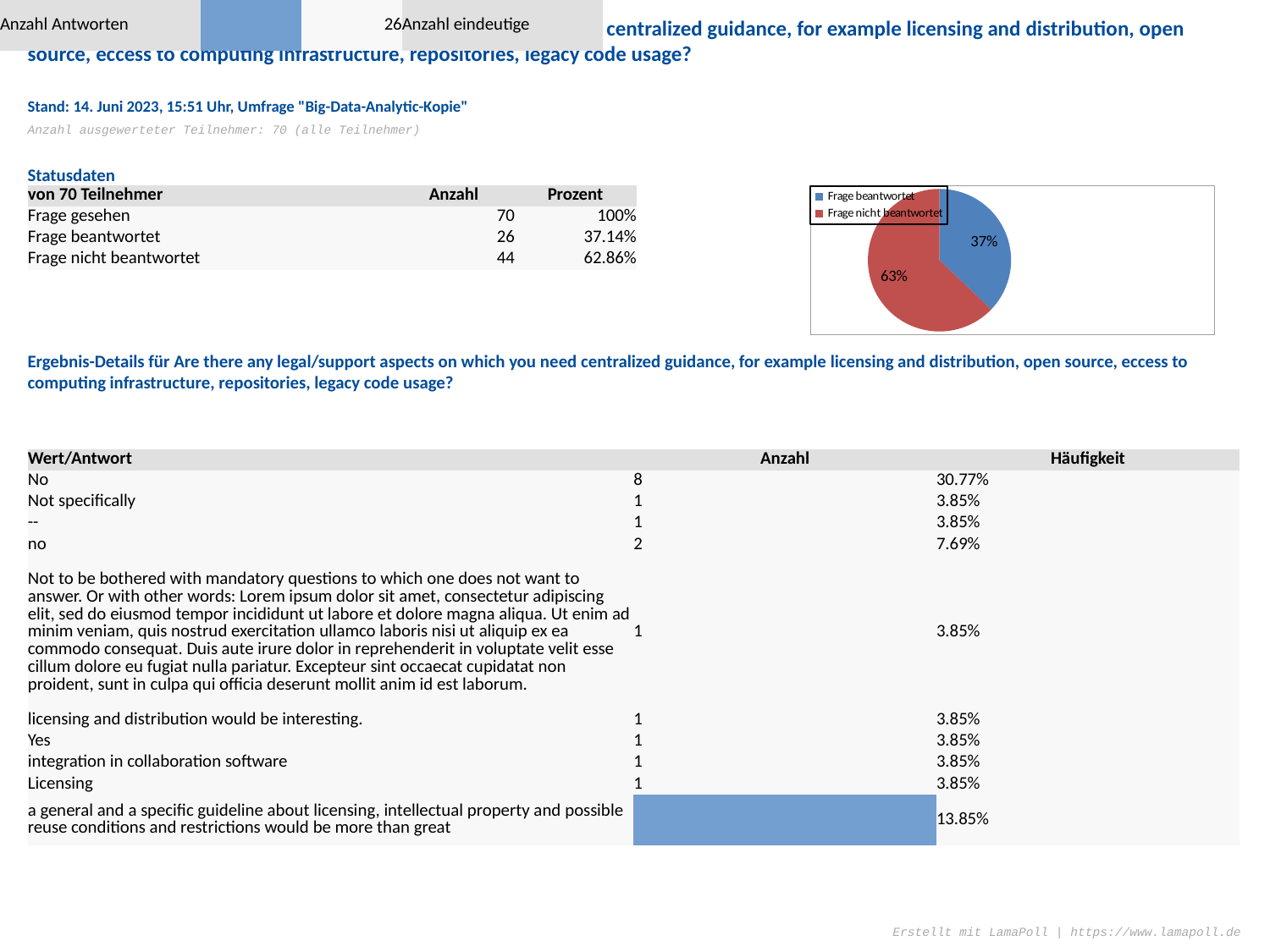
How many entries does the pie chart's legend list? 2 What kind of chart is shown on the slide? pie chart What share of the pie chart does "Frage beantwortet" represent? 37% What colour is the "Frage nicht beantwortet" slice in the pie chart? red Which is larger in the pie chart, "Frage beantwortet" or "Frage nicht beantwortet"? Frage nicht beantwortet What is the difference in percentage points between the "Frage nicht beantwortet" slice and the "Frage beantwortet" slice? 26 How many slices does the pie chart have? 2 Which slice of the pie chart is the smallest? Frage beantwortet What colour is the "Frage beantwortet" slice in the pie chart? blue What share of the pie chart does "Frage nicht beantwortet" represent? 63% Which slice of the pie chart is the largest? Frage nicht beantwortet